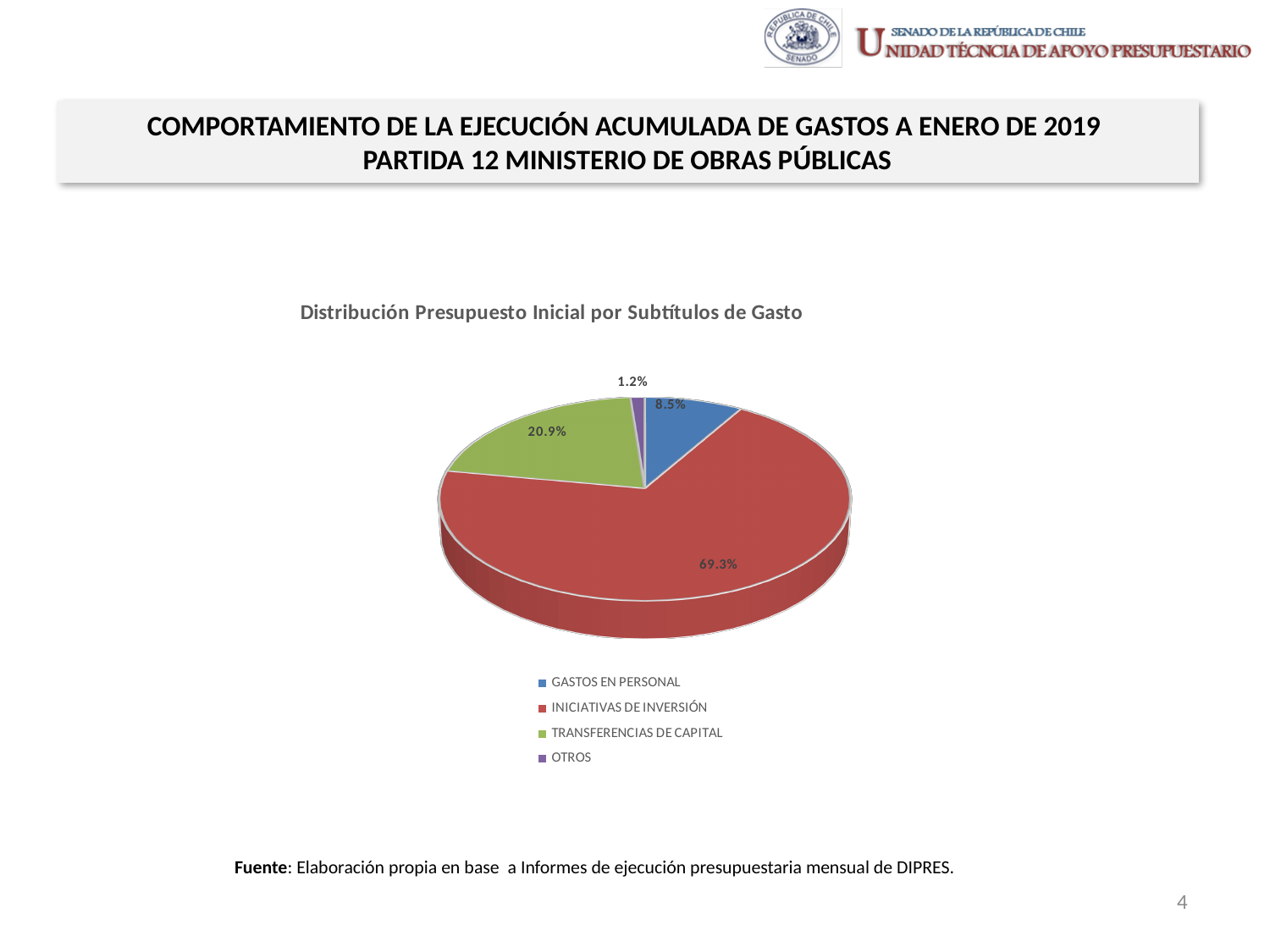
What share of the pie does OTROS represent? 1.2% What is the title of the chart? Distribución Presupuesto Inicial por Subtítulos de Gasto What type of chart is shown on the slide? Pie chart Which category has the smallest share of the pie? OTROS Which colour represents INICIATIVAS DE INVERSIÓN in the pie chart? Red What share of the pie does GASTOS EN PERSONAL represent? 8.5% How many categories does the pie chart show? 4 What share of the pie does TRANSFERENCIAS DE CAPITAL represent? 20.9% What is the difference in percentage points between the shares of INICIATIVAS DE INVERSIÓN and TRANSFERENCIAS DE CAPITAL? 48.4 percentage points Which is larger, the share for TRANSFERENCIAS DE CAPITAL or the share for GASTOS EN PERSONAL? TRANSFERENCIAS DE CAPITAL Which category has the largest share of the pie? INICIATIVAS DE INVERSIÓN